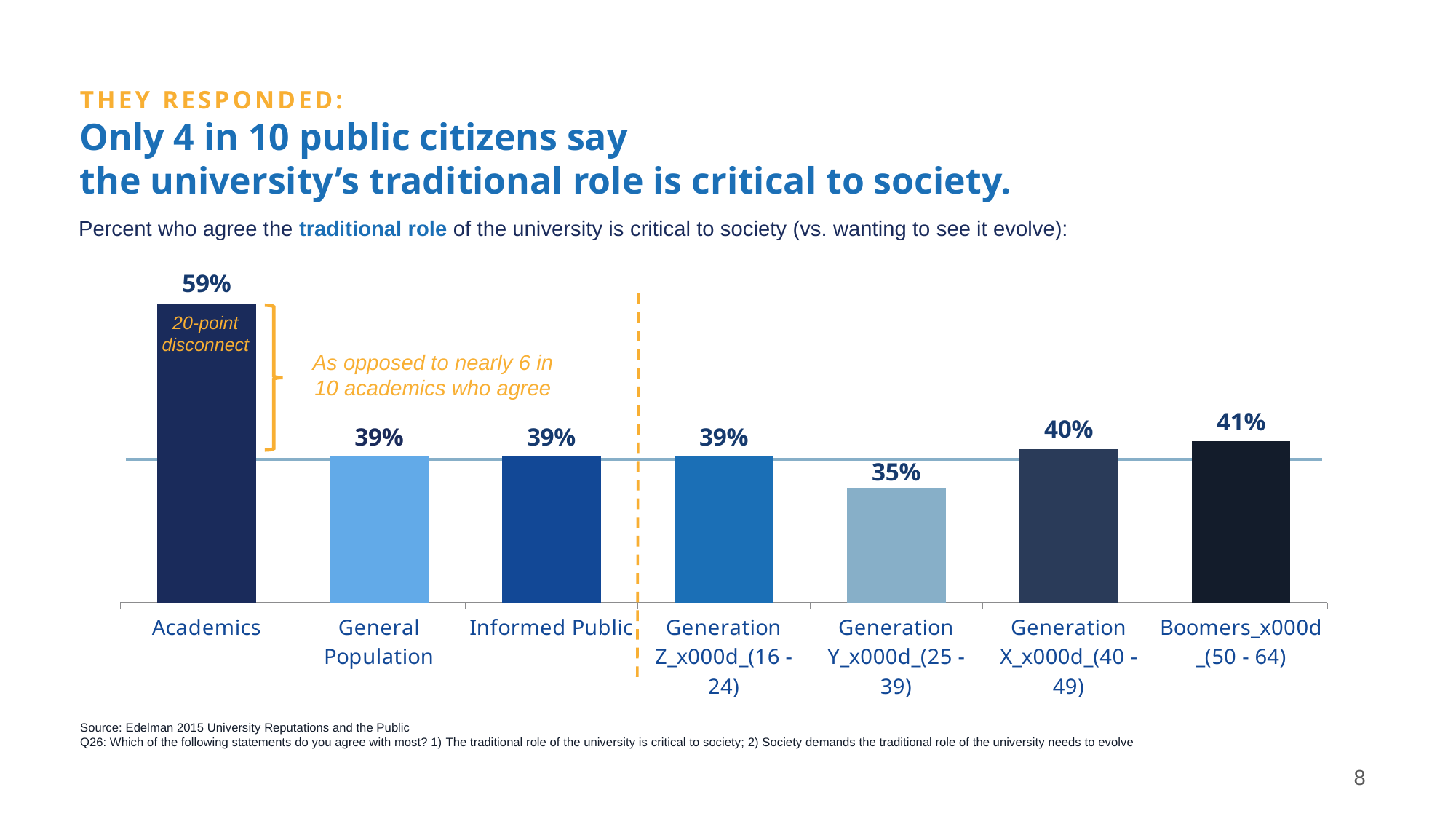
What is the value for the General Population? 39% What is the difference between the Academics value and the General Population value? 20 percentage points How many categories are shown in the chart? 7 What kind of chart is shown on the slide? Bar chart What is the difference between the Boomers (50 - 64) value and the Generation Y (25 - 39) value? 6 percentage points What does the annotation next to the Academics bar say the gap is? 20-point disconnect What is the value for Generation Y (25 - 39)? 35% Which category has the lowest value? Generation Y (25 - 39) Which category has the highest value? Academics What is the value for Boomers (50 - 64)? 41% Which is larger, the value for Generation X (40 - 49) or the value for Generation Z (16 - 24)? Generation X (40 - 49) What percentage of Academics agree the traditional role of the university is critical to society? 59%